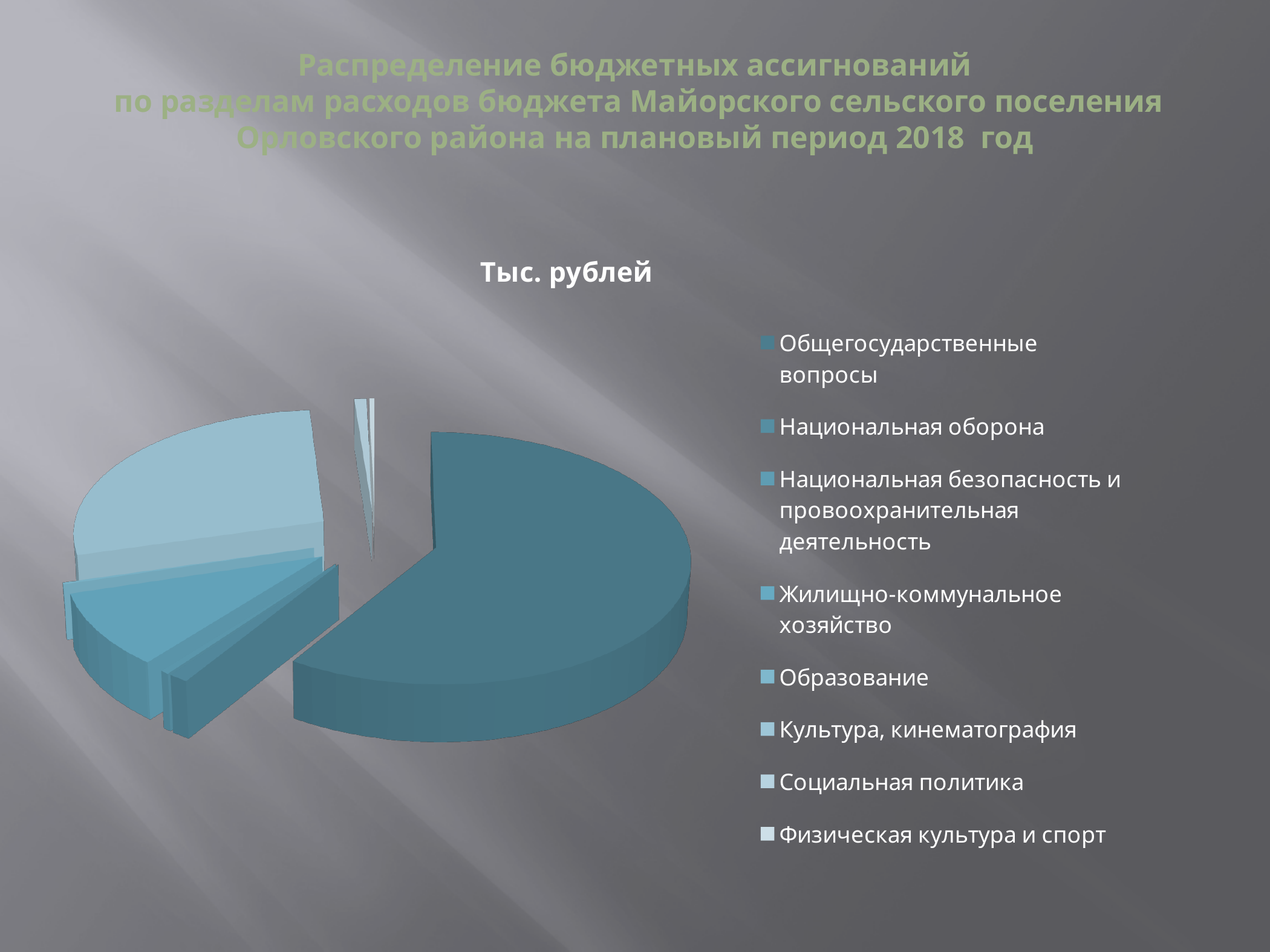
How many categories does the legend of the pie chart list? 8 Which is larger in the pie chart: Общегосударственные вопросы or Национальная оборона? Общегосударственные вопросы What kind of chart is shown on the slide? pie chart Which category has the largest slice in the pie chart? Общегосударственные вопросы Does the largest slice of the pie chart take up more or less than half of the pie? more What is the title shown above the pie chart? Тыс. рублей What is the first entry listed in the pie chart's legend? Общегосударственные вопросы Which is larger in the pie chart: Общегосударственные вопросы or Социальная политика? Общегосударственные вопросы